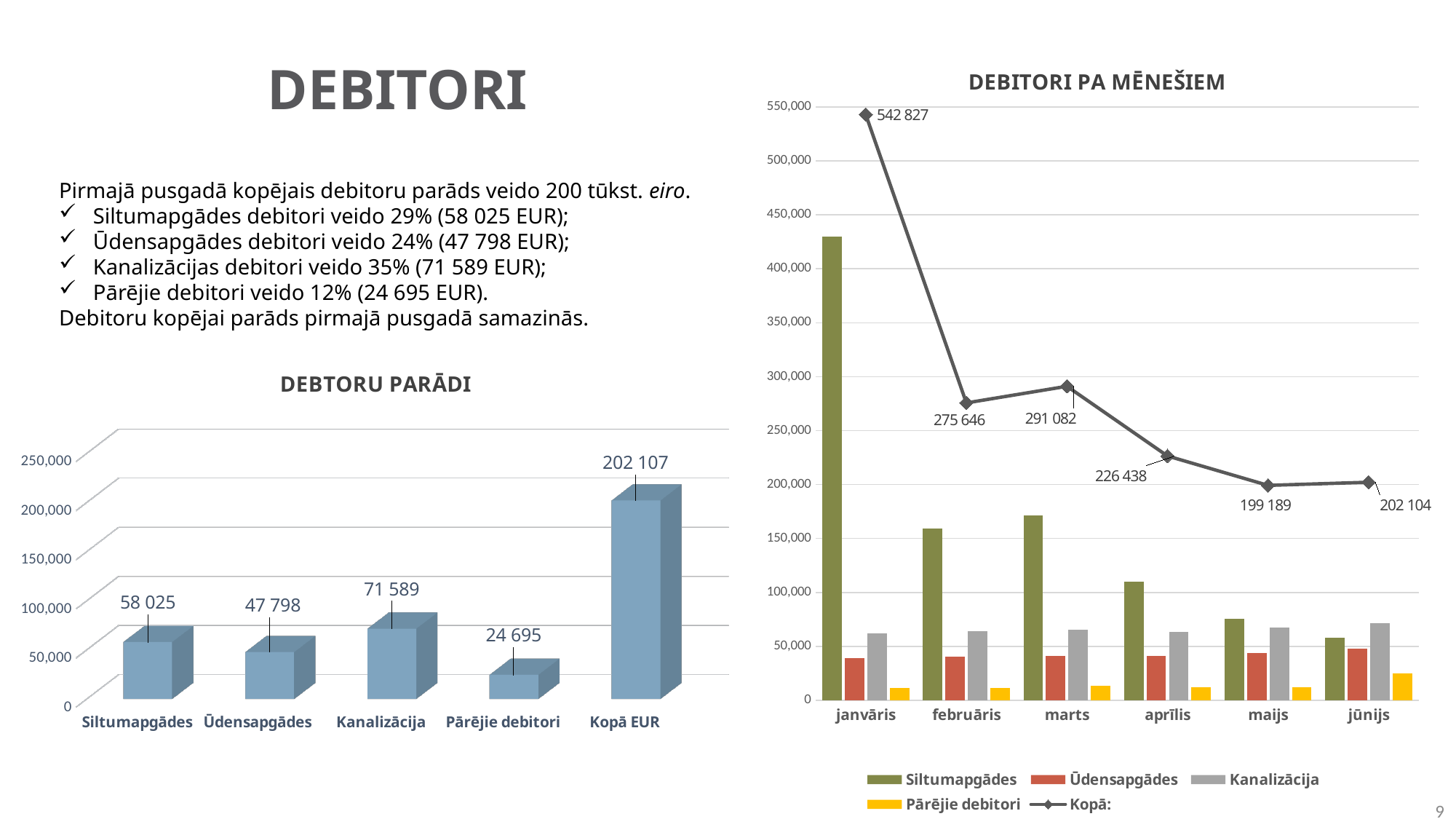
In the DEBITORI PA MĒNEŠIEM chart, does the Kopā line generally rise or fall from janvāris to jūnijs? fall In the DEBTORU PARĀDI chart, which category other than Kopā EUR has the highest value? Kanalizācija What kind of chart is DEBTORU PARĀDI? bar chart In the DEBTORU PARĀDI chart, what is the value for Kanalizācija? 71 589 In the DEBTORU PARĀDI chart, how many bars are plotted? 5 In the DEBITORI PA MĒNEŠIEM chart, what is the Kopā value for janvāris? 542 827 In the DEBTORU PARĀDI chart, which category has the lowest value? Pārējie debitori In the DEBTORU PARĀDI chart, what is the value for Pārējie debitori? 24 695 In the DEBITORI PA MĒNEŠIEM chart, what is the Kopā value for maijs? 199 189 In the DEBITORI PA MĒNEŠIEM chart, how many series does the legend list? 5 In the DEBTORU PARĀDI chart, what is the difference between Siltumapgādes and Ūdensapgādes? 10 227 In the DEBITORI PA MĒNEŠIEM chart, is the Siltumapgādes value for janvāris greater or less than 400,000? greater